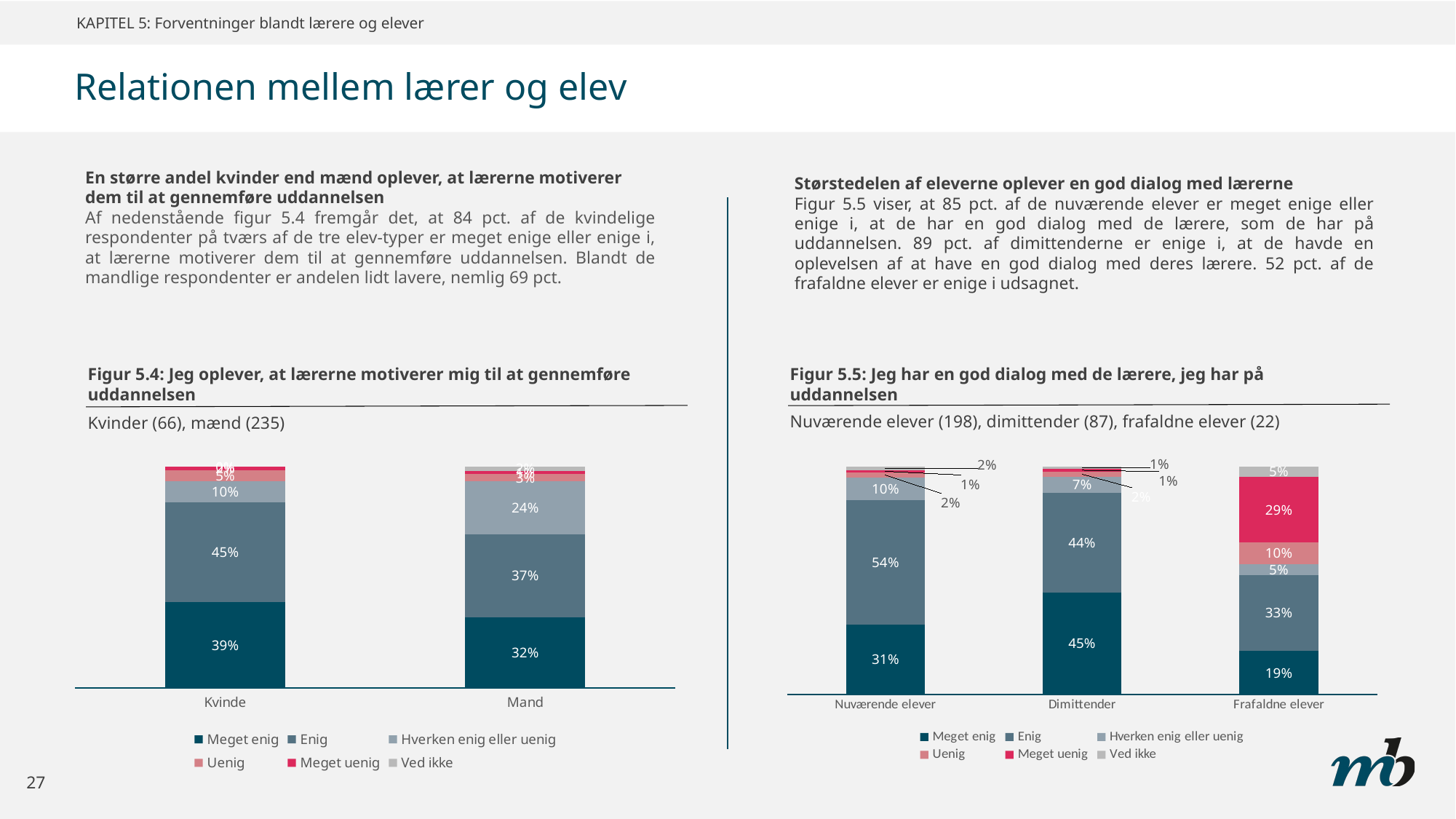
In Figur 5.5, what percentage of Frafaldne elever answered Meget uenig? 29% In Figur 5.5, what percentage of Dimittender answered Meget enig? 45% What kind of chart is Figur 5.5? Stacked bar chart In Figur 5.4, what percentage of Mand respondents answered Hverken enig eller uenig? 24% In Figur 5.5, which category has the highest Enig share? Nuværende elever In Figur 5.5, which category has the lowest Meget enig share? Frafaldne elever In Figur 5.5, how many categories are shown on the x axis? 3 In Figur 5.4, which category has the larger Meget enig share, Kvinde or Mand? Kvinde In Figur 5.4, what is the difference between the Enig share for Kvinde and for Mand? 8 percentage points In Figur 5.4, how many series does the legend list? 6 In Figur 5.5, what is the combined share of Meget enig and Enig for Nuværende elever? 85% In Figur 5.4, what percentage of Kvinde respondents answered Meget enig? 39%